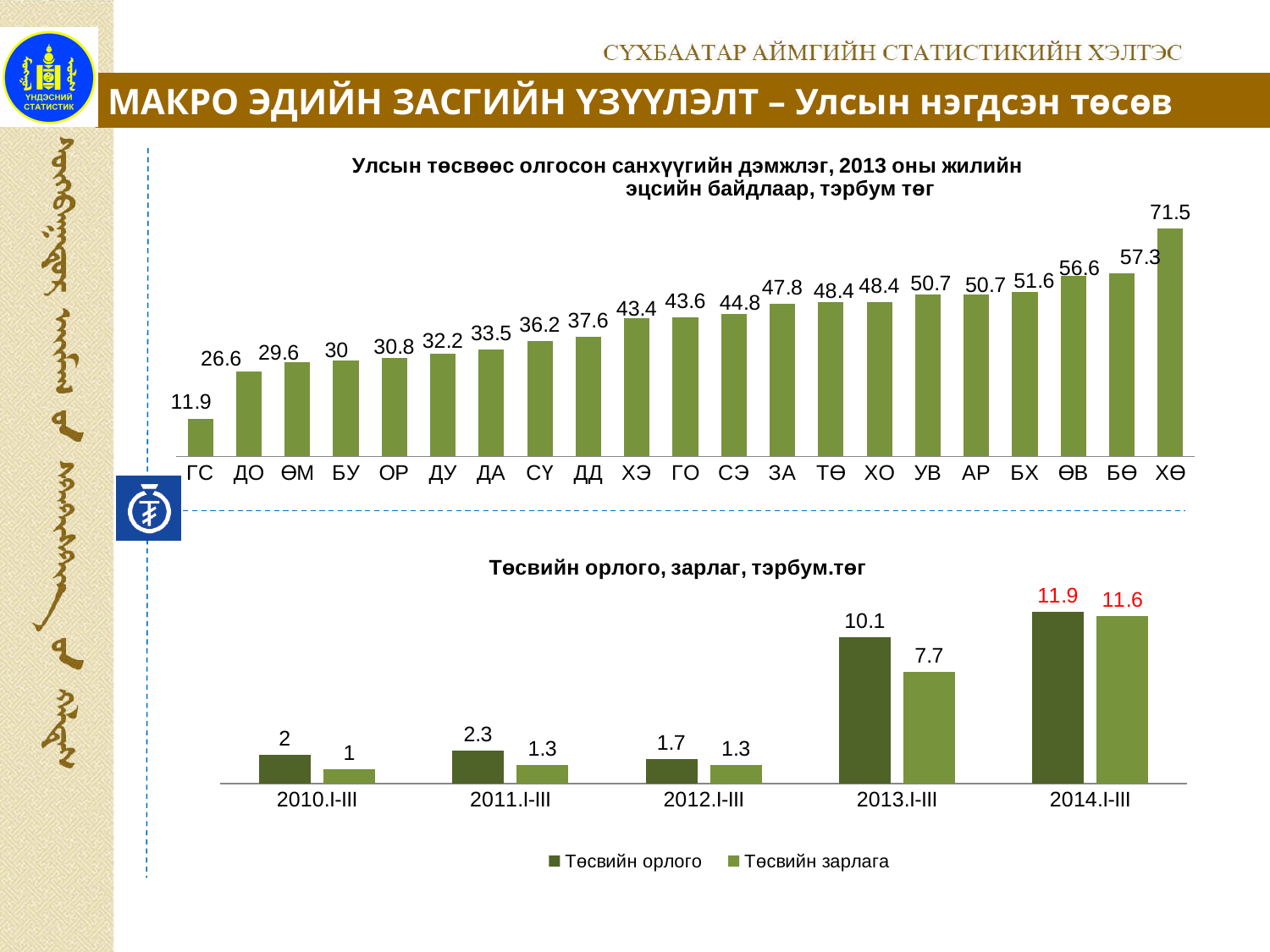
In the bottom chart (Төсвийн орлого, зарлаг), what is the difference between Төсвийн орлого and Төсвийн зарлага for 2013.I-III? 2.4 In the top chart (Улсын төсвөөс олгосон санхүүгийн дэмжлэг), which category has the highest value? ХӨ In the bottom chart (Төсвийн орлого, зарлаг), which is larger for 2014.I-III: Төсвийн орлого or Төсвийн зарлага? Төсвийн орлого In the top chart (Улсын төсвөөс олгосон санхүүгийн дэмжлэг), what is the difference between the values for ХӨ and БӨ? 14.2 In the top chart (Улсын төсвөөс олгосон санхүүгийн дэмжлэг), what is the value for ХЭ? 43.4 In the bottom chart (Төсвийн орлого, зарлаг), what is the value of Төсвийн зарлага for 2013.I-III? 7.7 In the top chart (Улсын төсвөөс олгосон санхүүгийн дэмжлэг), which category has the lowest value? ГС What type of chart is the bottom chart (Төсвийн орлого, зарлаг)? bar chart In the top chart (Улсын төсвөөс олгосон санхүүгийн дэмжлэг), do the values rise or fall from left to right? rise In the bottom chart (Төсвийн орлого, зарлаг), how many series does the legend list? 2 In the bottom chart (Төсвийн орлого, зарлаг), what is the value of Төсвийн орлого for 2011.I-III? 2.3 In the top chart (Улсын төсвөөс олгосон санхүүгийн дэмжлэг), how many categories are shown? 21